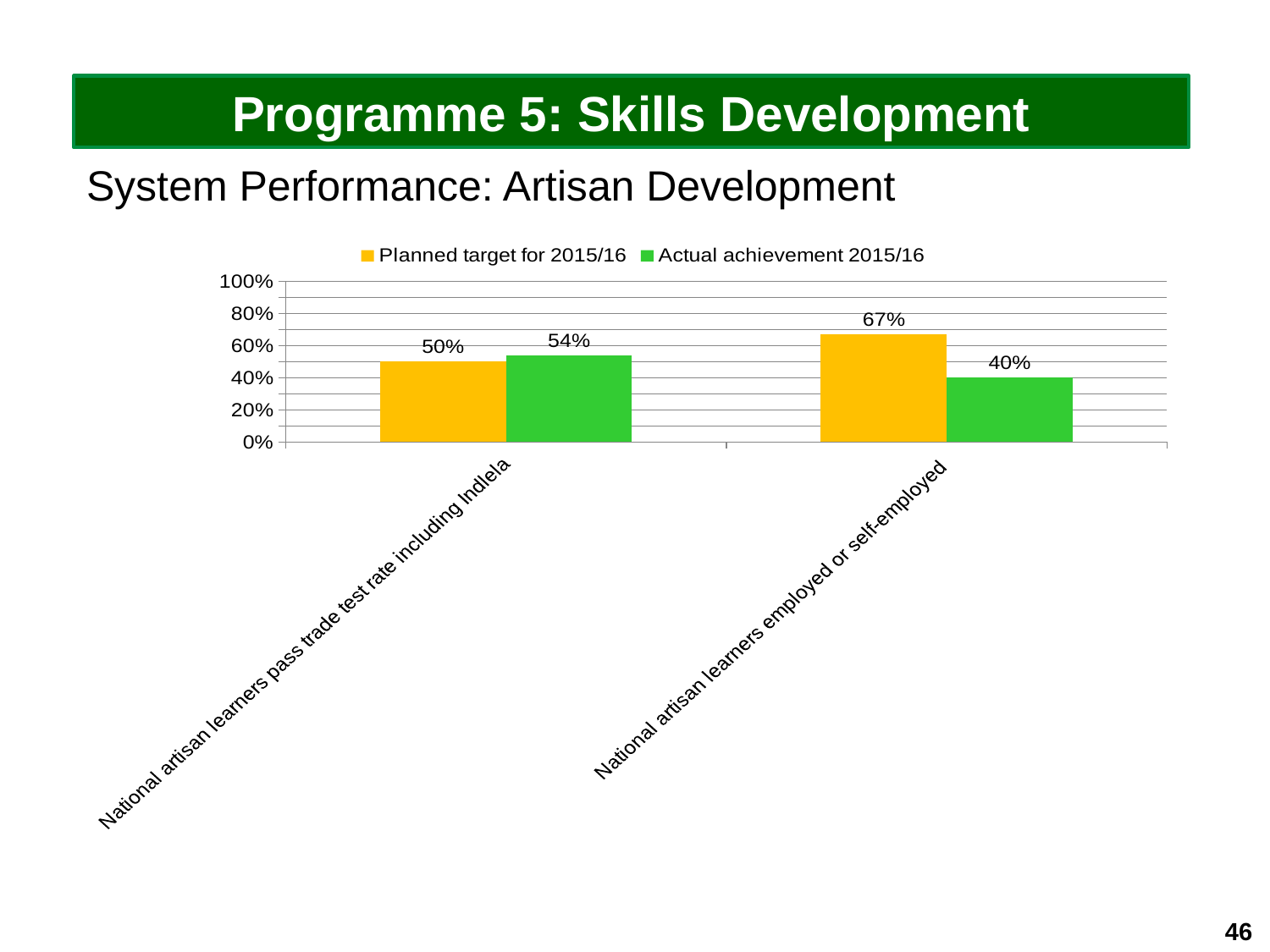
What kind of chart is shown on the slide? Bar chart Which category has the highest planned target for 2015/16? National artisan learners employed or self-employed What was the actual achievement in 2015/16 for national artisan learners pass trade test rate including Indlela? 54% How many categories are shown on the x axis of the chart? 2 Which category has the lowest actual achievement in 2015/16? National artisan learners employed or self-employed What was the planned target for 2015/16 for national artisan learners pass trade test rate including Indlela? 50% What was the actual achievement in 2015/16 for national artisan learners employed or self-employed? 40% How many series does the legend list? 2 What was the planned target for 2015/16 for national artisan learners employed or self-employed? 67% By how many percentage points did the actual achievement fall short of the planned target for national artisan learners employed or self-employed? 27% By how many percentage points did the actual achievement exceed the planned target for national artisan learners pass trade test rate including Indlela? 4% For national artisan learners employed or self-employed, which is larger: the planned target or the actual achievement? Planned target for 2015/16